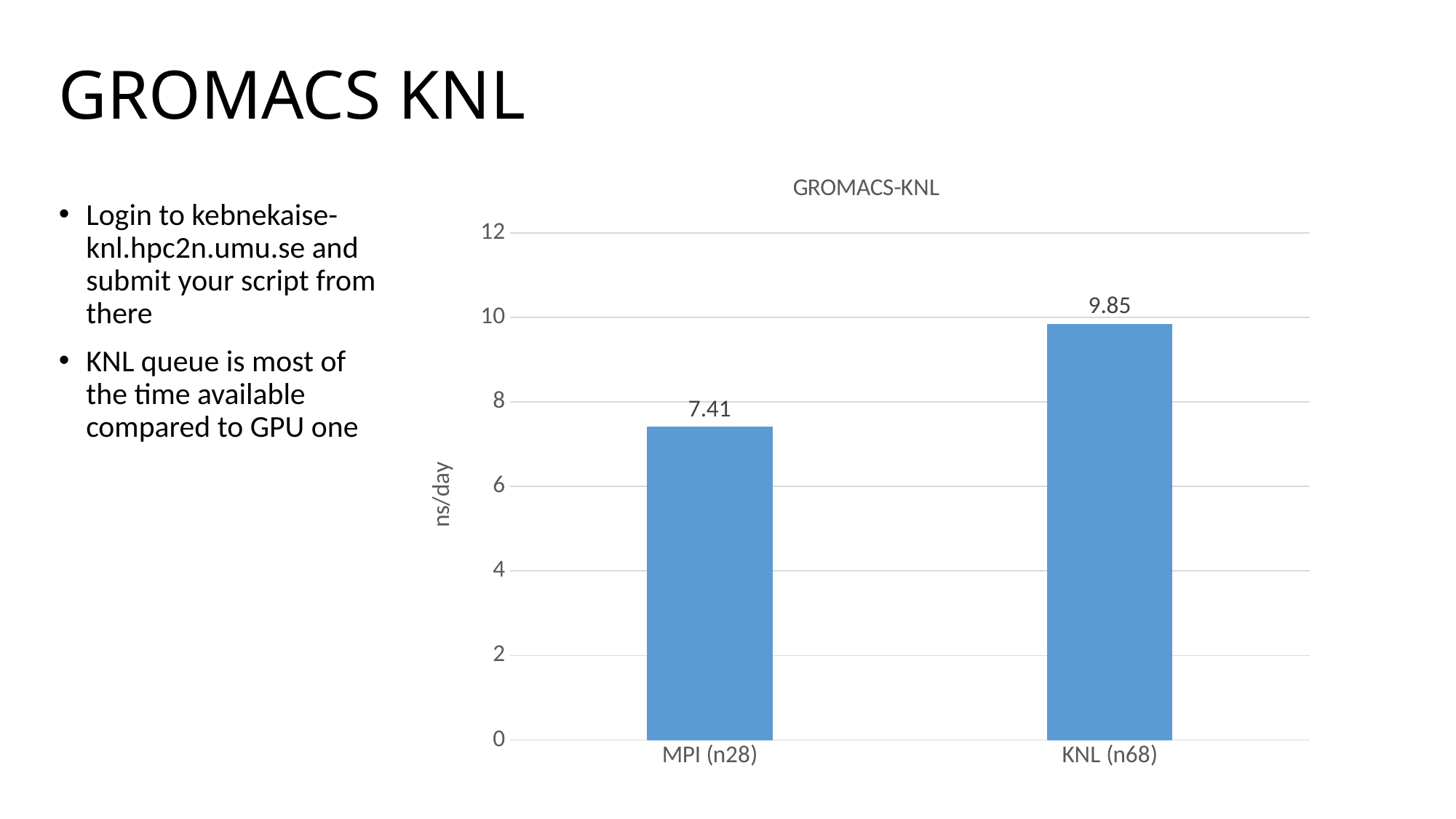
Which category has the lowest value? MPI (n28) Is the value for KNL (n68) greater or less than 8? greater What is the label of the y axis? ns/day Is the value for MPI (n28) greater or less than 8? less How many categories are shown on the x axis? 2 Which category has the highest value? KNL (n68) What is the value for MPI (n28)? 7.41 What kind of chart is shown? bar chart What is the value for KNL (n68)? 9.85 Which is larger, the value for MPI (n28) or the value for KNL (n68)? KNL (n68) What is the difference between the values for KNL (n68) and MPI (n28)? 2.44 What is the title of the chart? GROMACS-KNL